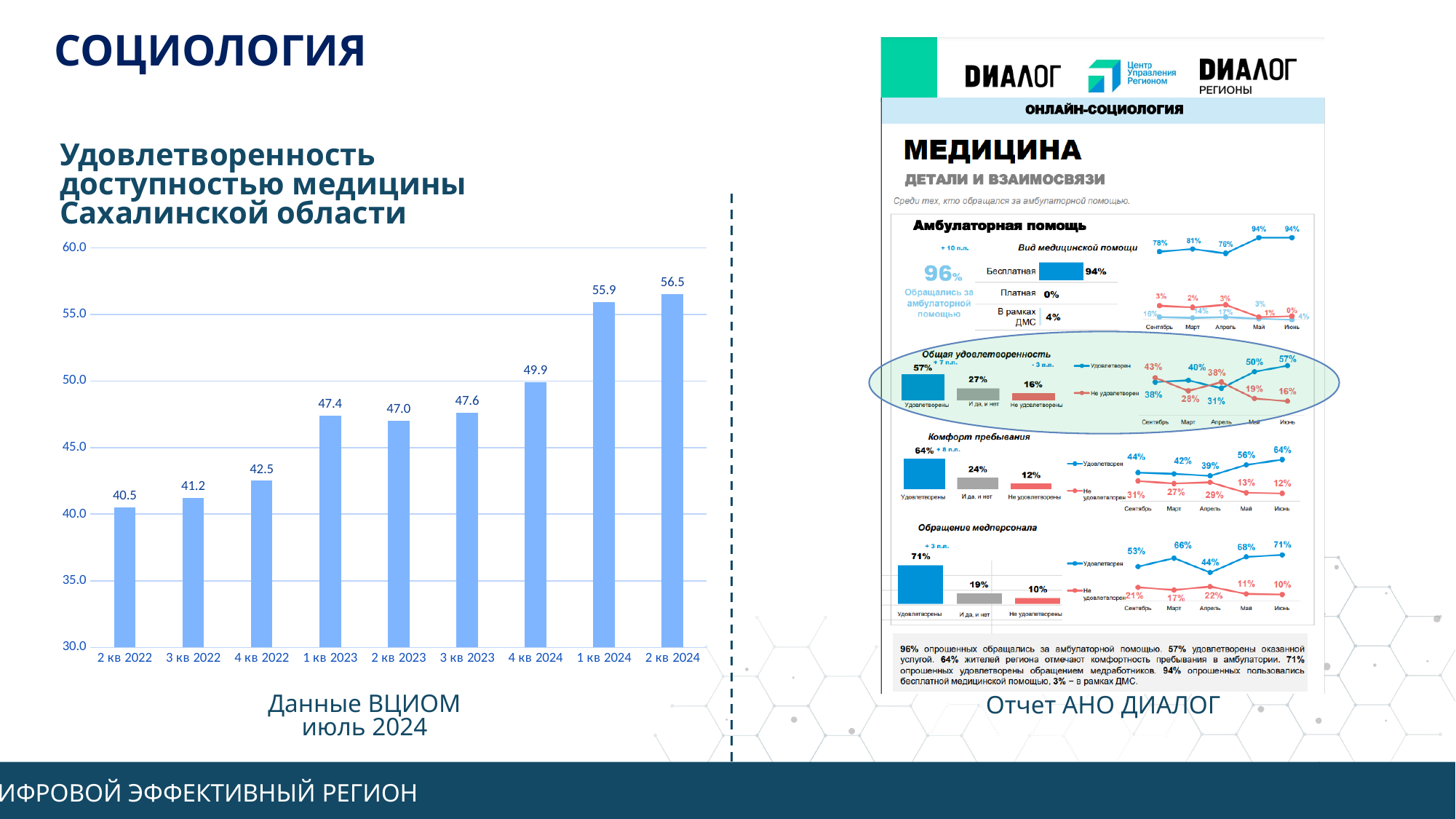
What kind of chart is 'Удовлетворенность доступностью медицины Сахалинской области'? bar chart What data source is cited below the bar chart on the left of the slide? Данные ВЦИОМ июль 2024 On the bar chart 'Удовлетворенность доступностью медицины Сахалинской области', what is the value for 1 кв 2023? 47.4 On the bar chart 'Удовлетворенность доступностью медицины Сахалинской области', which quarter has the lowest value? 2 кв 2022 On the bar chart 'Удовлетворенность доступностью медицины Сахалинской области', what is the value for 2 кв 2024? 56.5 On the bar chart 'Удовлетворенность доступностью медицины Сахалинской области', do the values generally rise or fall from 2 кв 2022 to 2 кв 2024? rise On the bar chart 'Удовлетворенность доступностью медицины Сахалинской области', which is larger: the value for 2 кв 2023 or 3 кв 2023? 3 кв 2023 On the bar chart 'Удовлетворенность доступностью медицины Сахалинской области', which quarter has the highest value? 2 кв 2024 How many quarters are shown on the bar chart 'Удовлетворенность доступностью медицины Сахалинской области'? 9 On the bar chart 'Удовлетворенность доступностью медицины Сахалинской области', what is the difference between the values for 2 кв 2024 and 2 кв 2022? 16.0 On the bar chart 'Удовлетворенность доступностью медицины Сахалинской области', is the value for 4 кв 2024 greater or less than 50.0? less On the bar chart 'Удовлетворенность доступностью медицины Сахалинской области', what is the value for 4 кв 2022? 42.5